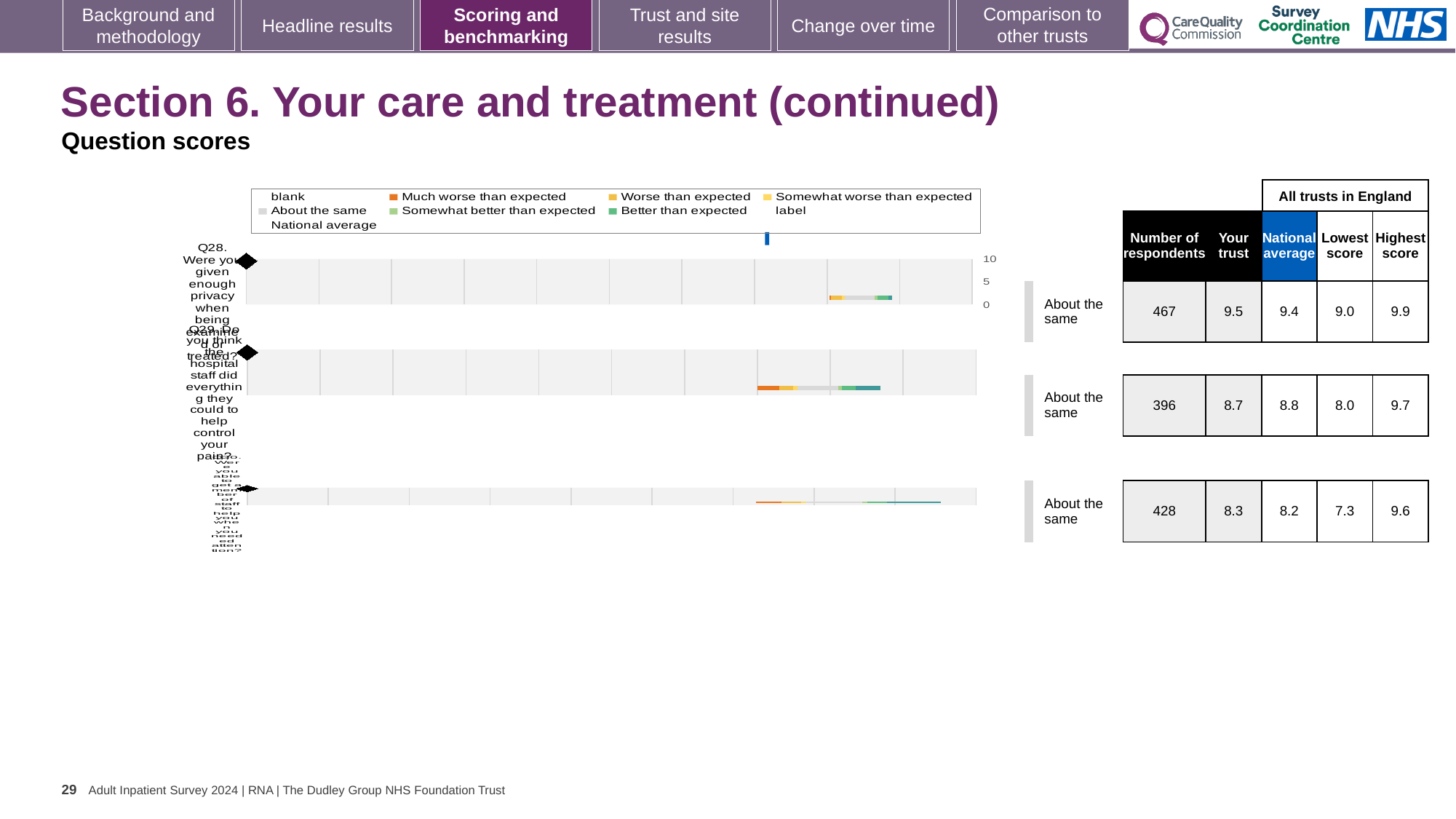
Which question has the lowest 'Your trust' score? Q30 Is the 'Your trust' score for Q28 on the chart greater or less than 5? greater Which question has the highest 'Your trust' score? Q28 What benchmarking category is shown for all three questions on this slide? About the same How many entries does the chart legend list? 9 For Q29, which is larger: the 'Your trust' score or the national average? National average What kind of chart is used to show the question scores on this slide? bar chart What is the number of respondents for Q30 (able to get a member of staff to help when needed)? 428 How many questions (rows) are plotted in the chart? 3 What is the 'Your trust' score for Q28 (enough privacy when being examined or treated)? 9.5 What is the difference between the highest score and the lowest score across all trusts in England for Q30? 2.3 What is the national average score for Q29 (hospital staff did everything to help control pain)? 8.8